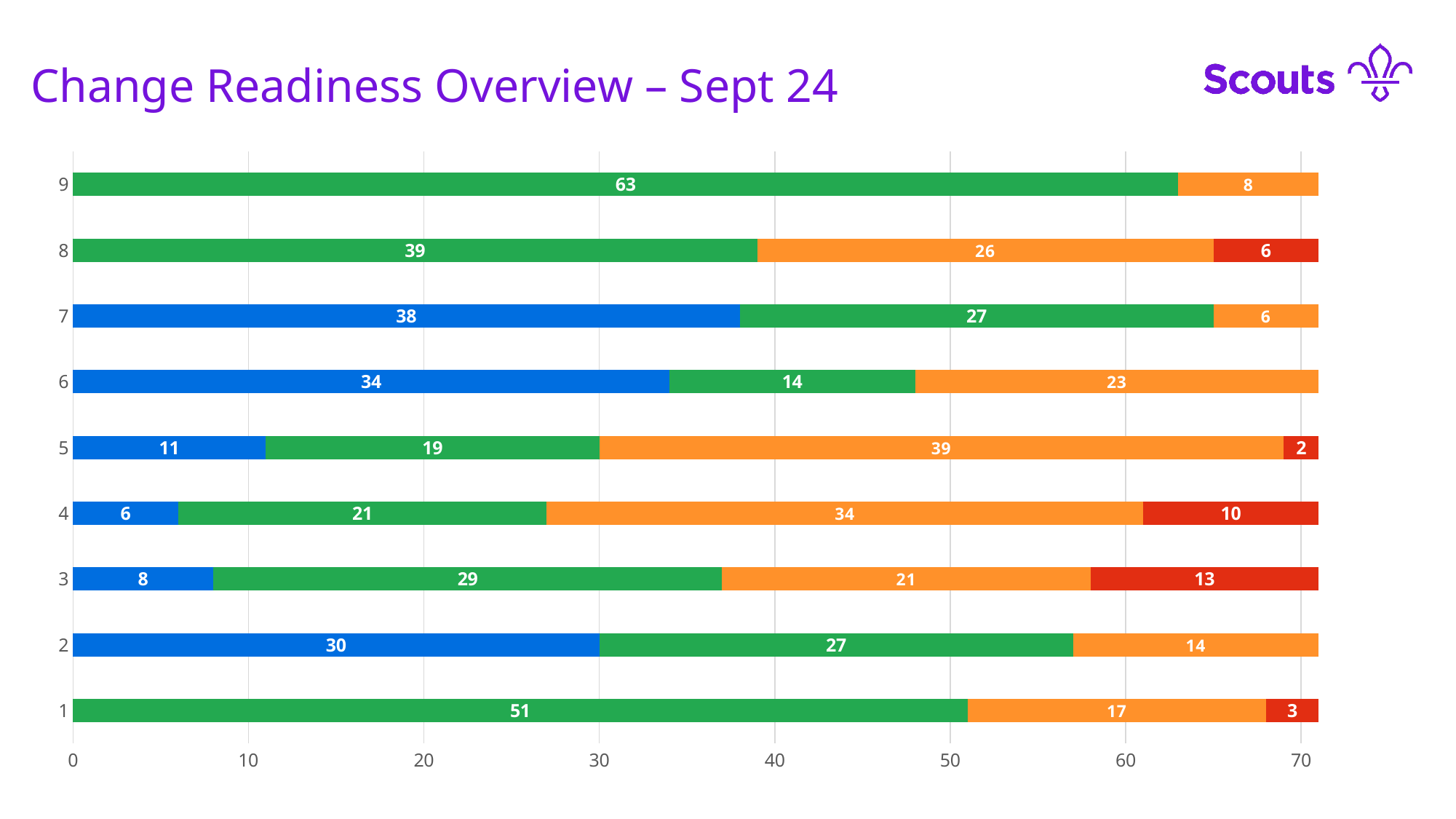
How many categories are shown on the chart? 9 What is the total of the stacked bar for category 4? 71 What is the title of the slide? Change Readiness Overview – Sept 24 Which category has the smallest blue segment? 4 Which category has the largest green segment? 9 Which is larger: the orange segment for category 6 or the orange segment for category 8? category 8 What is the value of the orange segment for category 5? 39 What is the value of the red segment for category 3? 13 What is the difference between the blue segment for category 2 and the blue segment for category 5? 19 What is the value of the blue segment for category 7? 38 What is the value of the green segment for category 9? 63 What kind of chart is shown on the slide? stacked bar chart